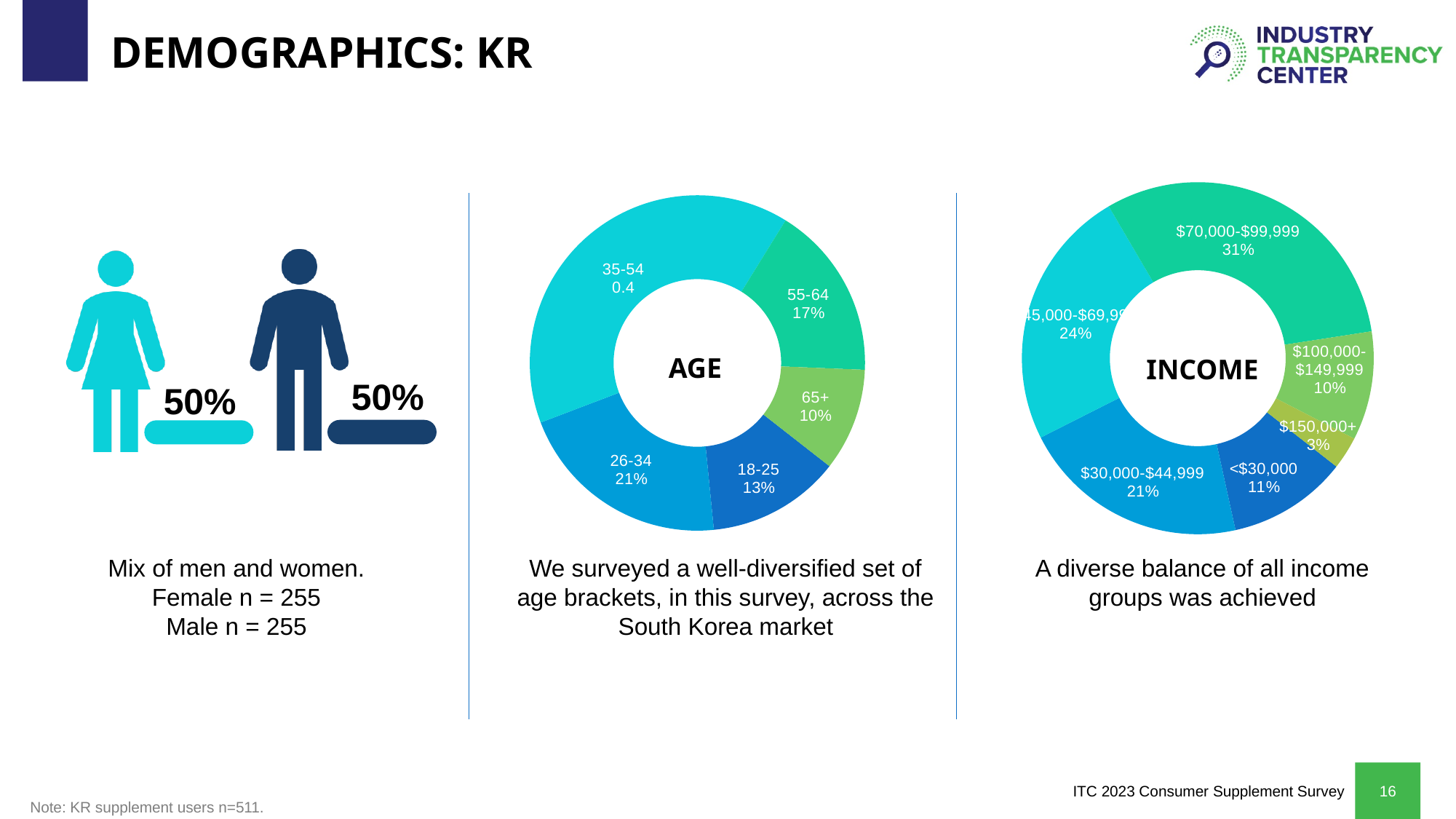
What type of chart is the AGE chart? Donut (pie) chart In the INCOME chart, which income group has the smallest share? $150,000+ In the INCOME chart, what is the difference in percentage points between the $30,000-$44,999 group and the <$30,000 group? 10 percentage points In the INCOME chart, what percentage of respondents earn $70,000-$99,999? 31% How many age brackets are shown in the AGE chart? 5 In the AGE chart, which age bracket has the smallest share? 65+ In the INCOME chart, which is larger: the share for <$30,000 or the share for $100,000-$149,999? <$30,000 In the AGE chart, what percentage of respondents are aged 55-64? 17% In the AGE chart, what is the difference in percentage points between the 26-34 and 18-25 brackets? 8 percentage points How many income groups are shown in the INCOME chart? 6 In the AGE chart, what value is printed on the 35-54 slice? 0.4 In the INCOME chart, which income group has the largest share? $70,000-$99,999